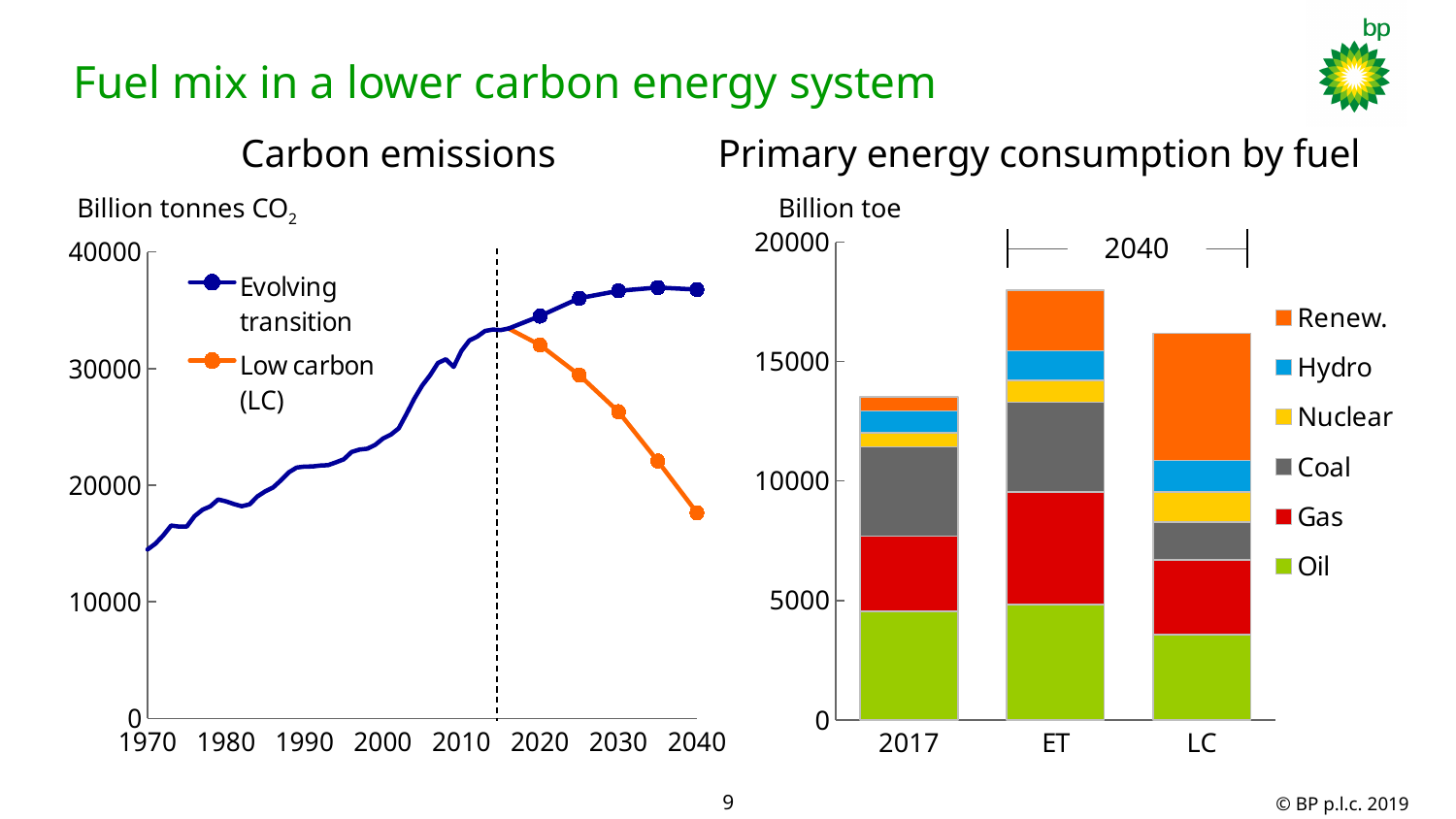
How many fuel series does the legend of the Primary energy consumption by fuel chart list? 6 What unit is shown on the Carbon emissions chart? Billion tonnes CO2 In the Carbon emissions chart, which series has the higher value in 2040, Evolving transition or Low carbon (LC)? Evolving transition In the Carbon emissions chart, is the Evolving transition value in 2040 greater or less than 30000? greater In the Carbon emissions chart, is the Low carbon (LC) value in 2040 greater or less than 20000? less In the Primary energy consumption by fuel chart, which bar is the tallest? ET What kind of chart is the Primary energy consumption by fuel chart? bar chart How many bars are shown in the Primary energy consumption by fuel chart? 3 In the Carbon emissions chart, does the Low carbon (LC) series rise or fall between 2020 and 2040? fall What kind of chart is the Carbon emissions chart? line chart How many series does the legend of the Carbon emissions chart list? 2 In the Primary energy consumption by fuel chart, is the total for 2017 greater or less than 15000? less